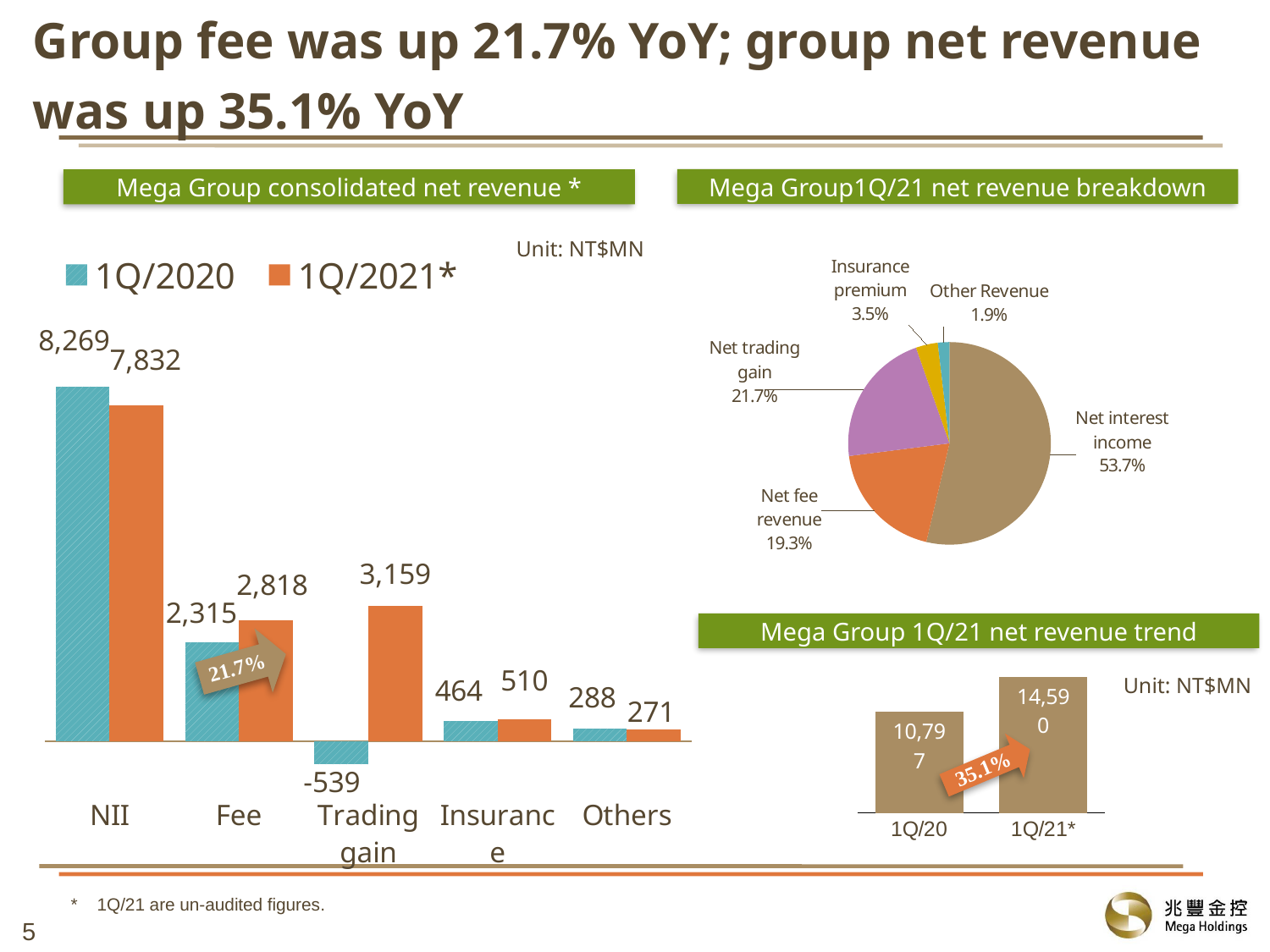
In the Mega Group consolidated net revenue chart, what is the 1Q/2021* value for Trading gain? 3,159 In the Mega Group 1Q/21 net revenue breakdown pie chart, what share is Net interest income? 53.7% In the Mega Group consolidated net revenue chart, what is the 1Q/2020 value for NII? 8,269 In the Mega Group 1Q/21 net revenue breakdown pie chart, which slice is the smallest? Other Revenue In the Mega Group consolidated net revenue chart, what is the difference between the 1Q/2021* and 1Q/2020 values for Fee? 503 How many series does the legend of the Mega Group consolidated net revenue chart list? 2 In the Mega Group consolidated net revenue chart, is the 1Q/2021* value for Insurance larger or smaller than the 1Q/2020 value? larger What type of chart is the Mega Group 1Q/21 net revenue breakdown? pie chart In the Mega Group 1Q/21 net revenue trend chart, what is the value for 1Q/21*? 14,590 In the Mega Group consolidated net revenue chart, which category has the lowest 1Q/2021* value? Others How many categories are shown on the x axis of the Mega Group consolidated net revenue chart? 5 In the Mega Group consolidated net revenue chart, what is the 1Q/2020 value for Trading gain? -539